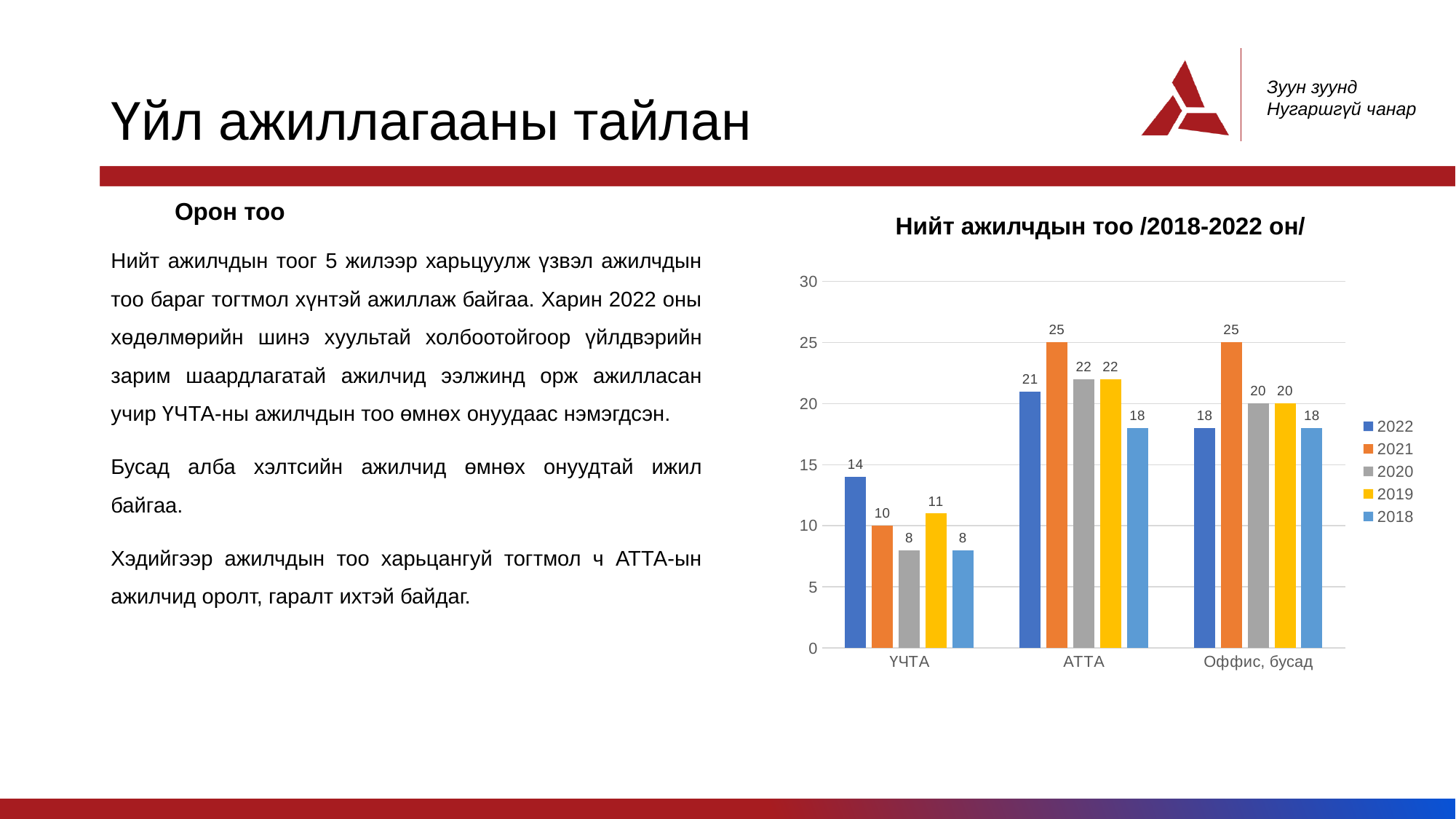
What is the value for Оффис, бусад in 2018? 18 What is the title of the chart? Нийт ажилчдын тоо /2018-2022 он/ What is the value for ҮЧТА in 2022? 14 Is the 2022 value for АТТА greater or less than 20? greater Which year has the highest value for ҮЧТА? 2022 How many series does the legend list? 5 Which year has the lowest value for АТТА? 2018 Which is larger for ҮЧТА: the 2021 value or the 2019 value? 2019 How many categories are shown on the x axis? 3 What kind of chart is shown on the slide? bar chart What is the difference between the 2021 and 2018 values for АТТА? 7 What is the value for АТТА in 2021? 25